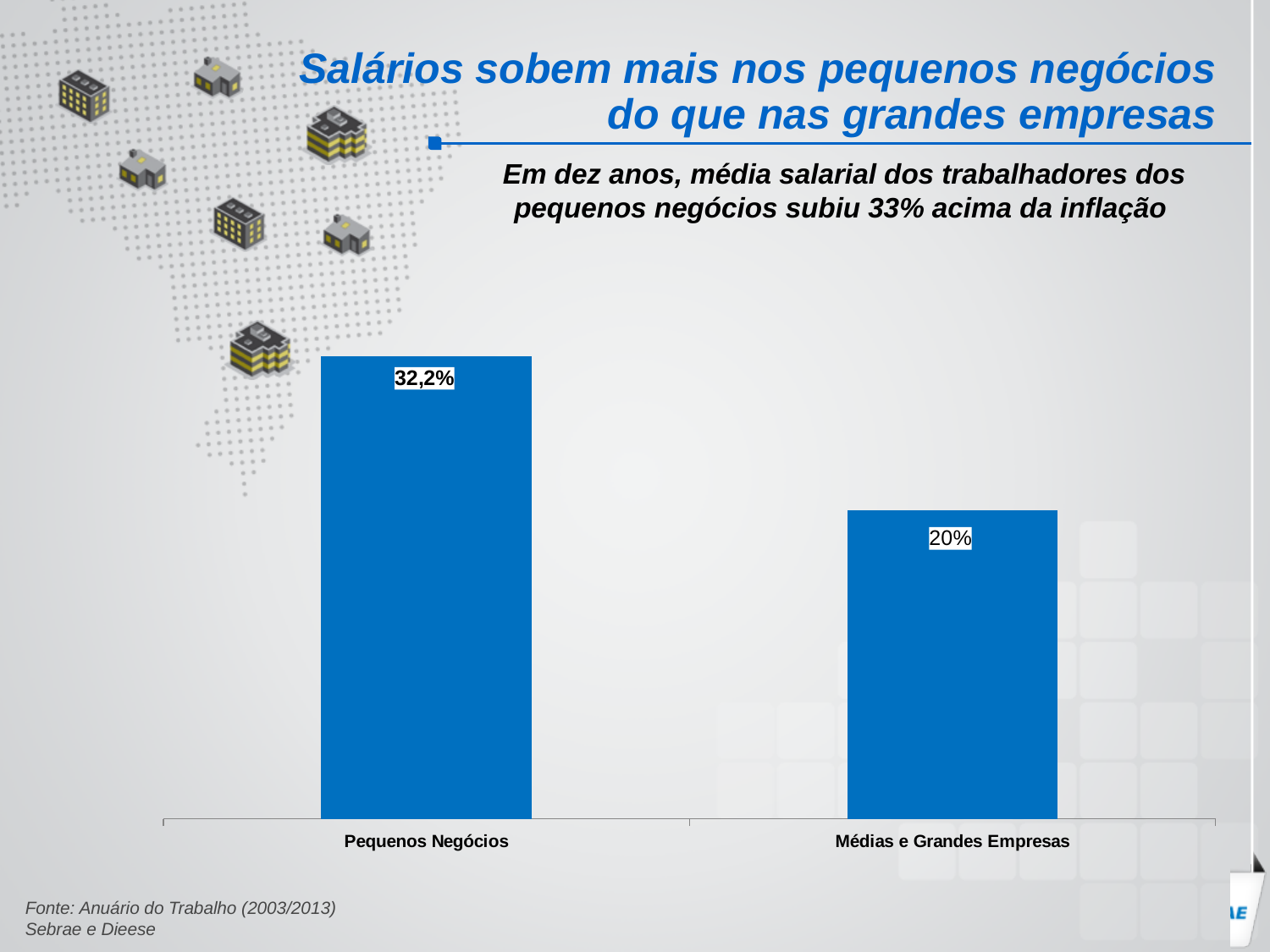
What is the source cited at the bottom of the slide? Anuário do Trabalho (2003/2013) Sebrae e Dieese What kind of chart is shown on the slide? Bar chart Which is larger, the value for Pequenos Negócios or the value for Médias e Grandes Empresas? Pequenos Negócios What is the value for Pequenos Negócios? 32,2% What is the difference between the values for Pequenos Negócios and Médias e Grandes Empresas? 12,2% How many categories are shown in the chart? 2 What is the value for Médias e Grandes Empresas? 20% What colour are the bars in the chart? Blue Which category has the lowest value? Médias e Grandes Empresas Which category has the highest value? Pequenos Negócios